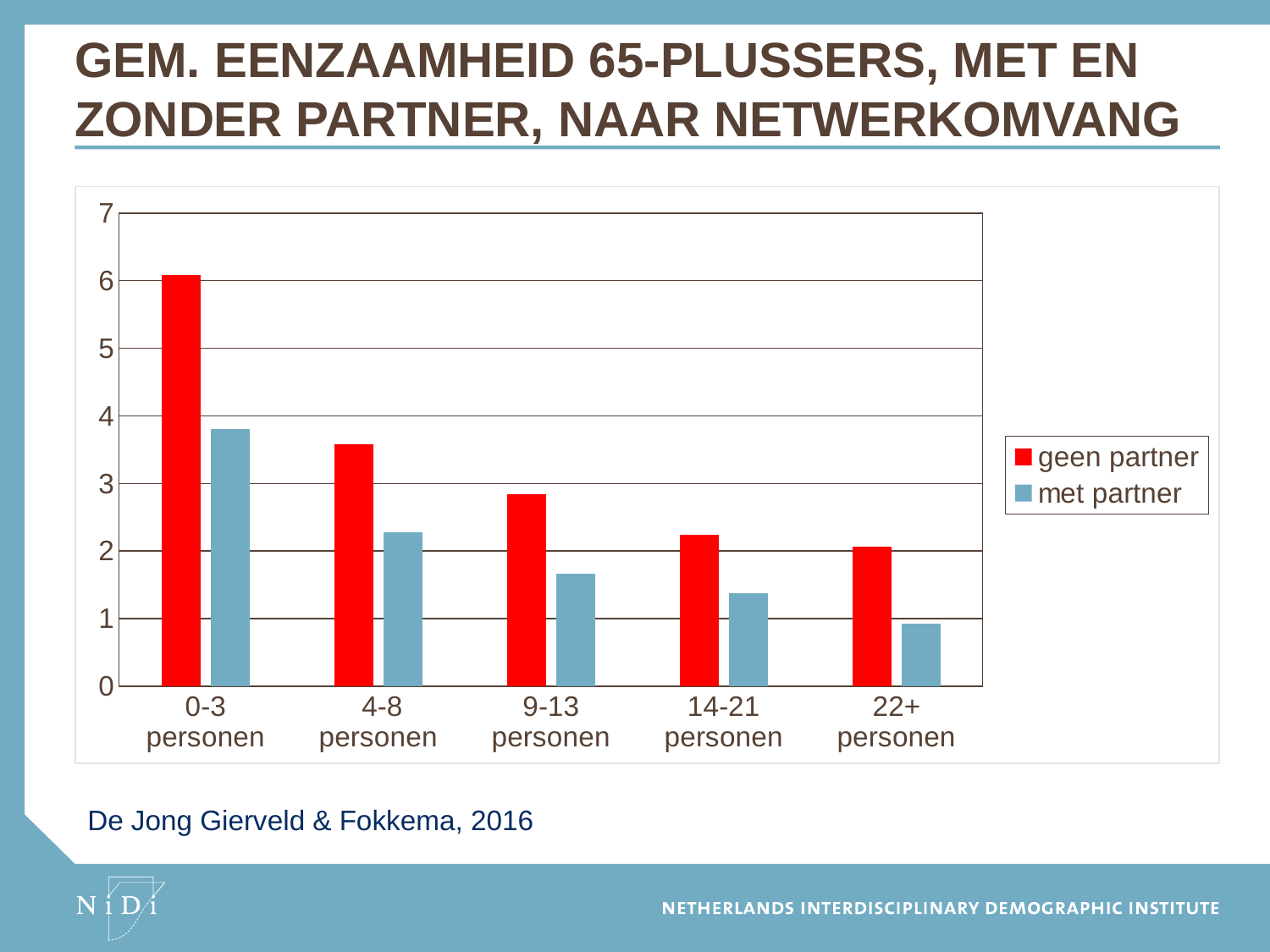
Which category has the lowest value for 'met partner'? 22+ personen For the 0-3 personen category, which is larger: 'geen partner' or 'met partner'? geen partner How many network-size categories are shown on the x axis? 5 How many series does the legend list? 2 Is the value for 'met partner' in the 0-3 personen category greater or less than 4? less Is the value for 'geen partner' in the 0-3 personen category greater or less than 5? greater Is the value for 'geen partner' in the 4-8 personen category greater or less than 3? greater What kind of chart is shown on the slide? bar chart Which category has the highest value for 'geen partner'? 0-3 personen Do the 'geen partner' values rise or fall as network size increases along the x axis? fall What colour are the 'met partner' bars? blue